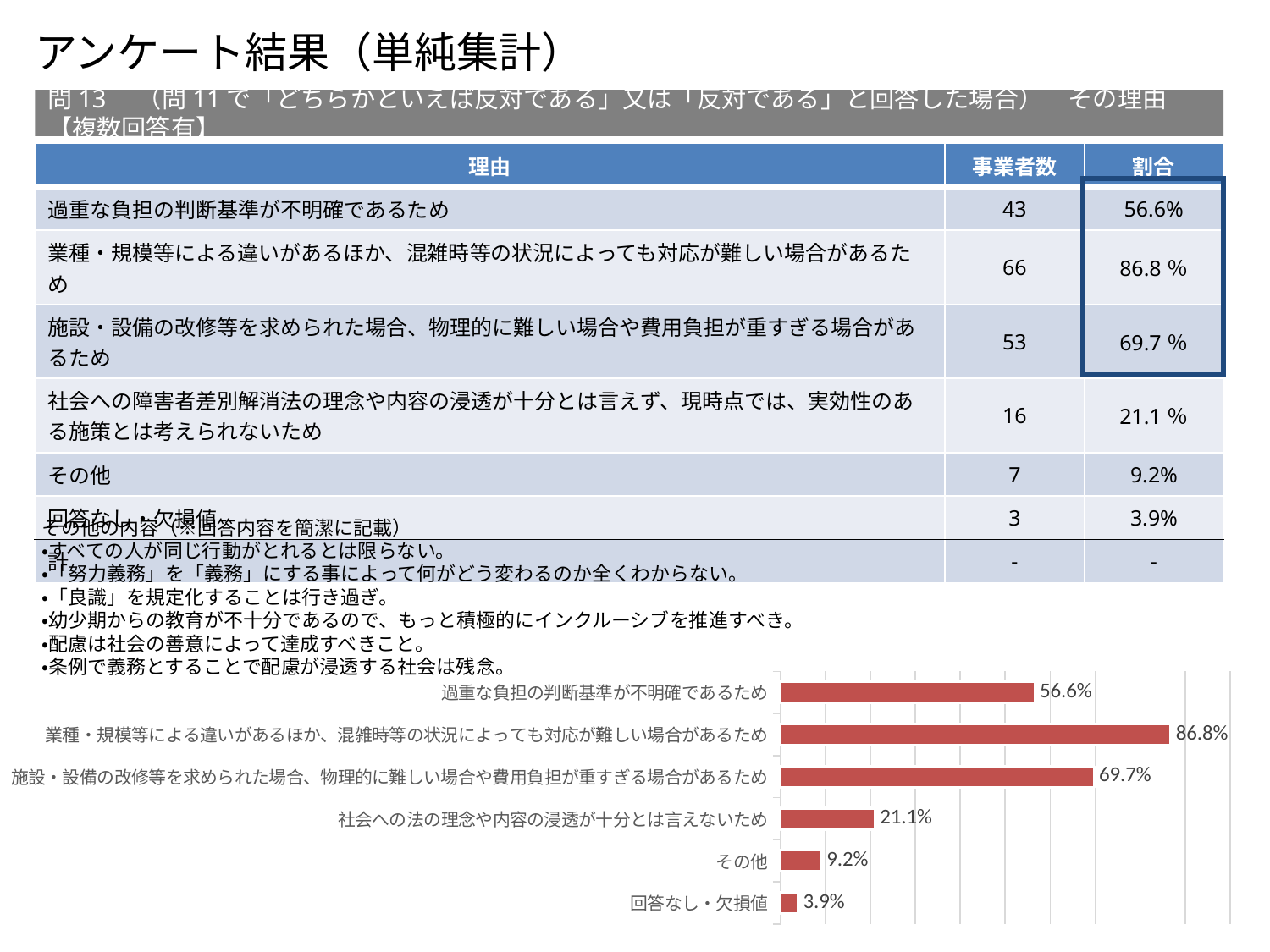
What is the difference between the values for 業種・規模等による違いがあるほか、混雑時等の状況によっても対応が難しい場合があるため and 施設・設備の改修等を求められた場合、物理的に難しい場合や費用負担が重すぎる場合があるため? 17.1% Which is larger in the chart: the value for その他 or the value for 回答なし・欠損値? その他 How many categories (bars) does the chart show? 6 What is the value shown for 社会への法の理念や内容の浸透が十分とは言えないため in the chart? 21.1% What is the value shown for 過重な負担の判断基準が不明確であるため in the chart? 56.6% What is the value shown for 施設・設備の改修等を求められた場合、物理的に難しい場合や費用負担が重すぎる場合があるため in the chart? 69.7% What is the value shown for 回答なし・欠損値 in the chart? 3.9% What is the difference between the values for 過重な負担の判断基準が不明確であるため and 社会への法の理念や内容の浸透が十分とは言えないため? 35.5% Which category has the lowest value in the chart? 回答なし・欠損値 Which category has the highest value in the chart? 業種・規模等による違いがあるほか、混雑時等の状況によっても対応が難しい場合があるため What kind of chart is shown at the bottom of the slide? bar chart What is the value shown for 業種・規模等による違いがあるほか、混雑時等の状況によっても対応が難しい場合があるため in the chart? 86.8%